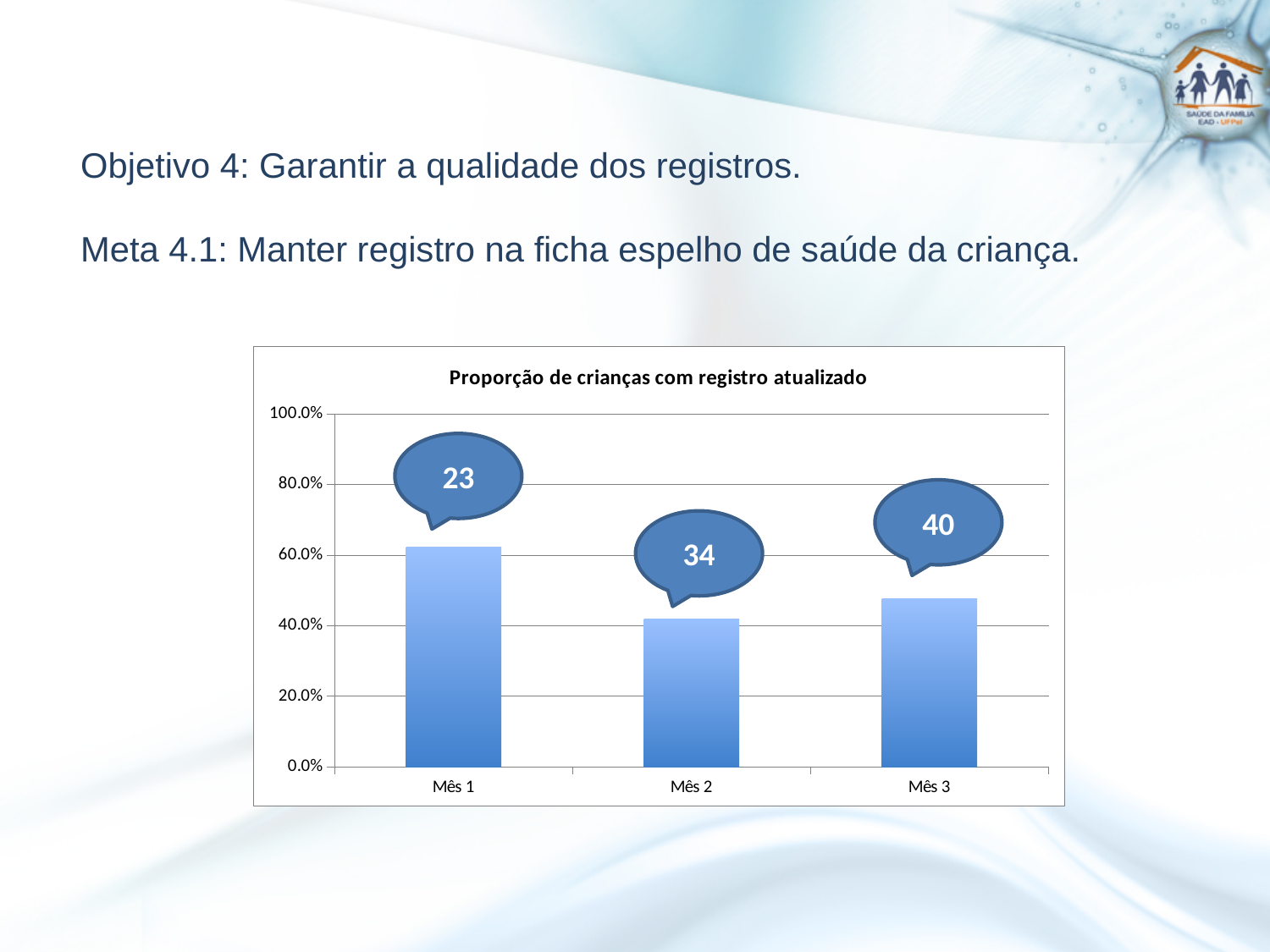
Which has a higher value, Mês 3 or Mês 2? Mês 3 Which month has the lowest proportion of children with updated records? Mês 2 How many months (categories) are shown on the x axis of the chart? 3 What is the title of the chart? Proporção de crianças com registro atualizado Which month has the highest proportion of children with updated records? Mês 1 Is the value for Mês 2 greater or less than 60.0%? less Does the value rise or fall from Mês 1 to Mês 2? fall Is the value for Mês 1 greater or less than 40.0%? greater What kind of chart is shown on the slide? bar chart What number is shown in the callout above the Mês 3 bar? 40 Is the value for Mês 3 greater or less than 60.0%? less Which has a higher value, Mês 1 or Mês 3? Mês 1